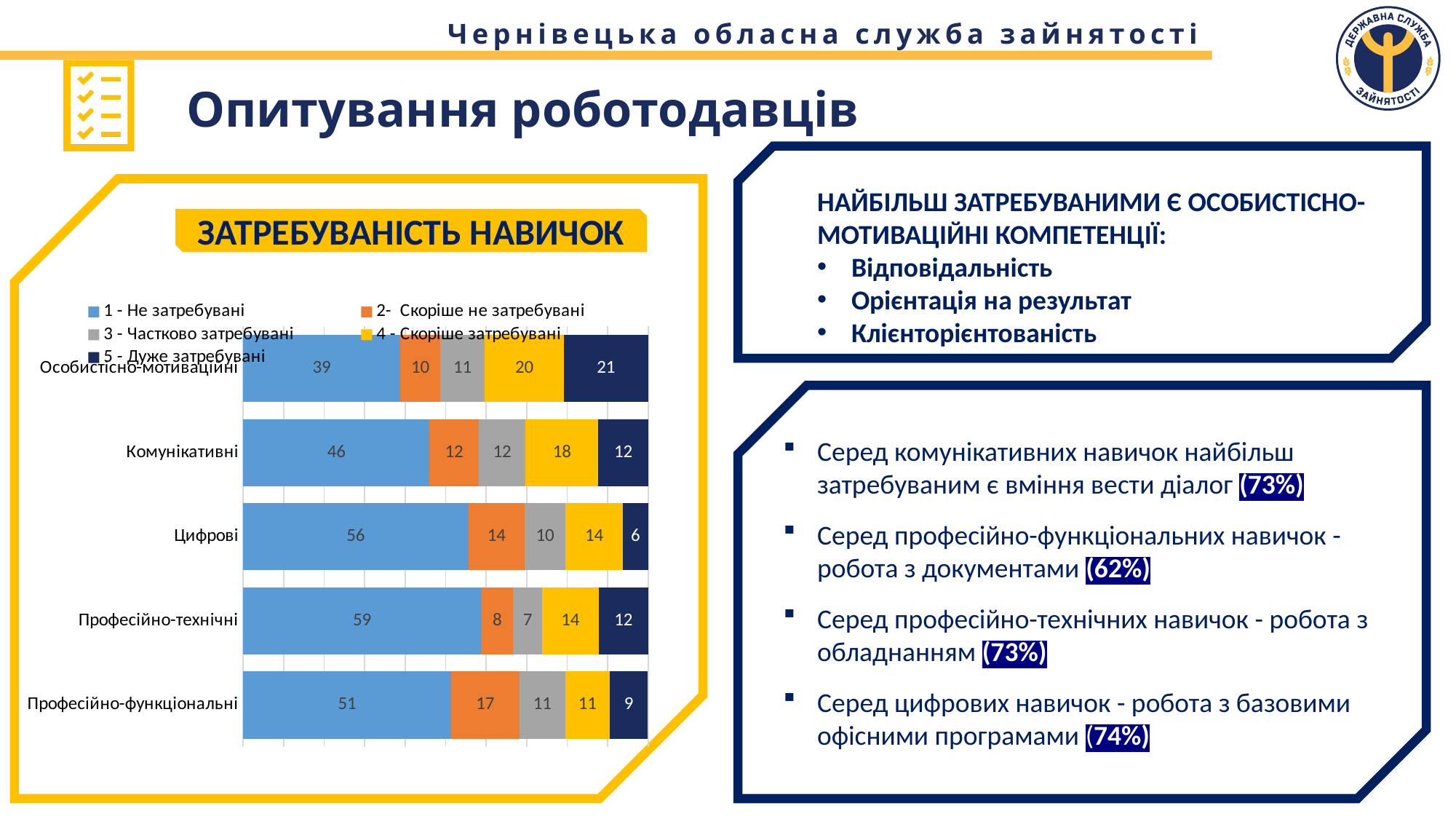
What is the value of "1 - Не затребувані" for the category "Цифрові"? 56 How many skill categories are plotted in the chart? 5 Which category has the lowest value for "5 - Дуже затребувані"? Цифрові What kind of chart is shown under the heading "ЗАТРЕБУВАНІСТЬ НАВИЧОК"? Stacked bar chart Which colour represents the series "5 - Дуже затребувані" in the chart? Dark navy blue Which category has the highest value for "1 - Не затребувані"? Професійно-технічні What is the value of "5 - Дуже затребувані" for the category "Особистісно-мотиваційні"? 21 Which is larger: the "3 - Частково затребувані" value for "Комунікативні" or for "Професійно-технічні"? Комунікативні How many series does the chart legend list? 5 What is the total of the stacked bar for "Професійно-технічні"? 100 What is the difference between the "4 - Скоріше затребувані" values for "Особистісно-мотиваційні" and "Комунікативні"? 2 What is the value of "2- Скоріше не затребувані" for the category "Професійно-функціональні"? 17